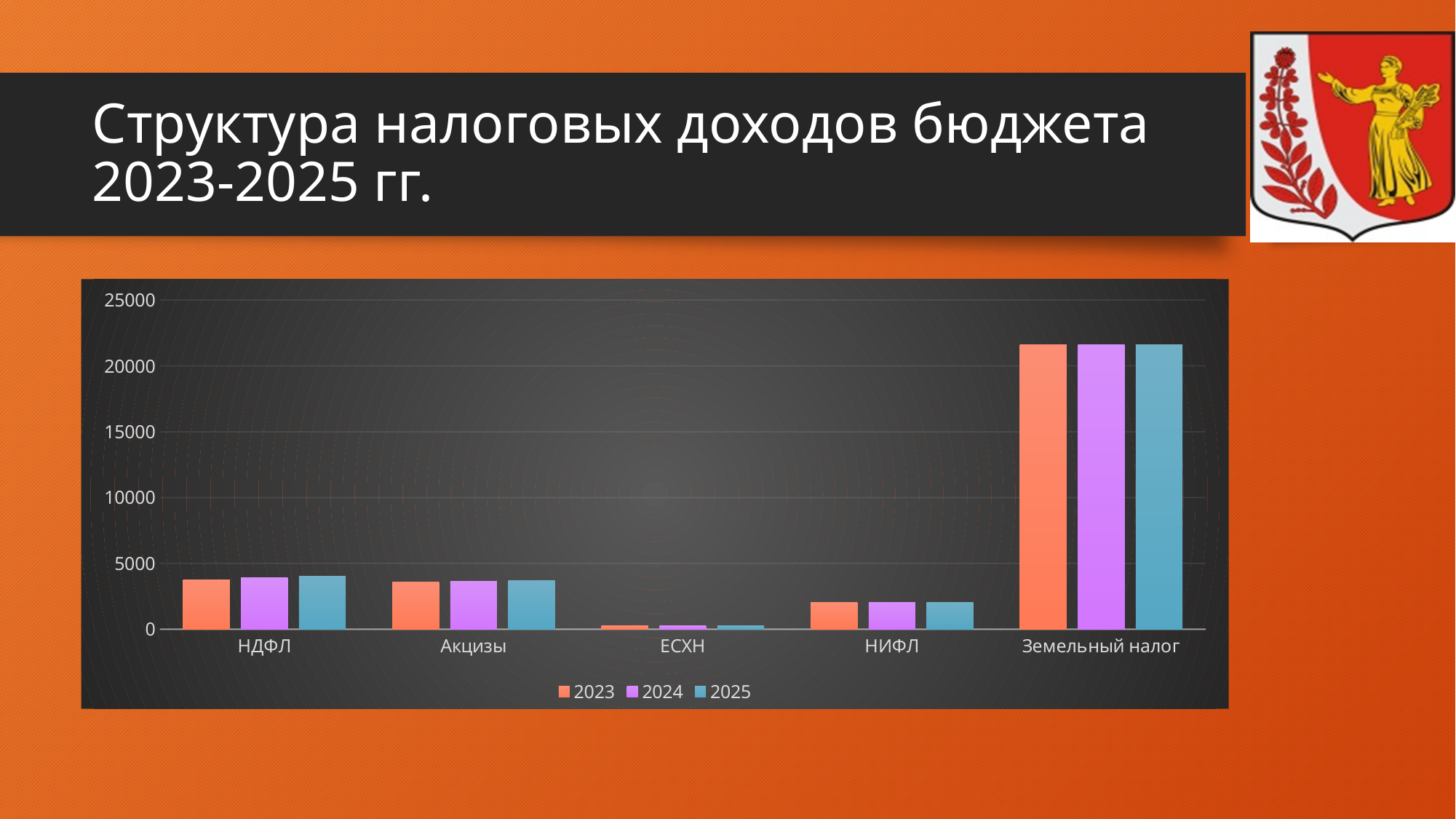
Is the value for НИФЛ in 2024 greater or less than 5000? less Which is larger for 2025: Акцизы or ЕСХН? Акцизы What is the title of the slide containing the chart? Структура налоговых доходов бюджета 2023-2025 гг. What kind of chart is shown on the slide? Bar chart Which series is shown in purple in the chart legend? 2024 How many series does the chart legend list? 3 Is the value for Земельный налог in 2023 greater or less than 20000? greater Which category has the lowest values in the chart? ЕСХН Which is larger for 2023: НДФЛ or НИФЛ? НДФЛ Which category has the highest values in the chart? Земельный налог Is the value for НДФЛ in 2025 greater or less than 5000? less How many categories are shown on the x axis of the chart? 5